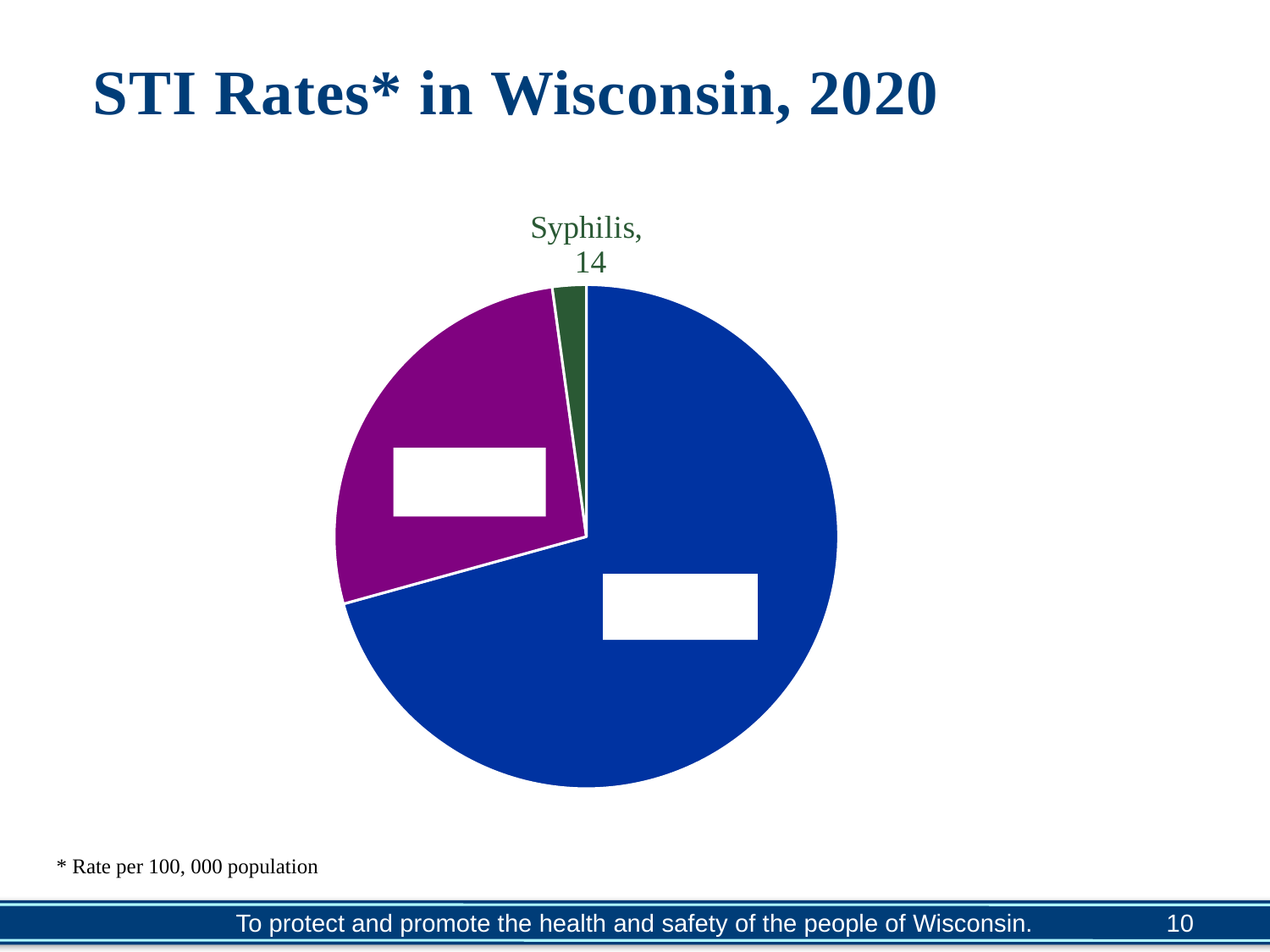
What colour is the Syphilis slice in the pie chart? green What kind of chart is shown on the slide? pie chart Which labeled category has the smallest slice in the pie chart? Syphilis What is the value shown for Syphilis in the pie chart? 14 What is the title of the chart on the slide? STI Rates* in Wisconsin, 2020 How many slices does the pie chart have? 3 Is the Syphilis slice the largest or the smallest slice in the pie chart? smallest